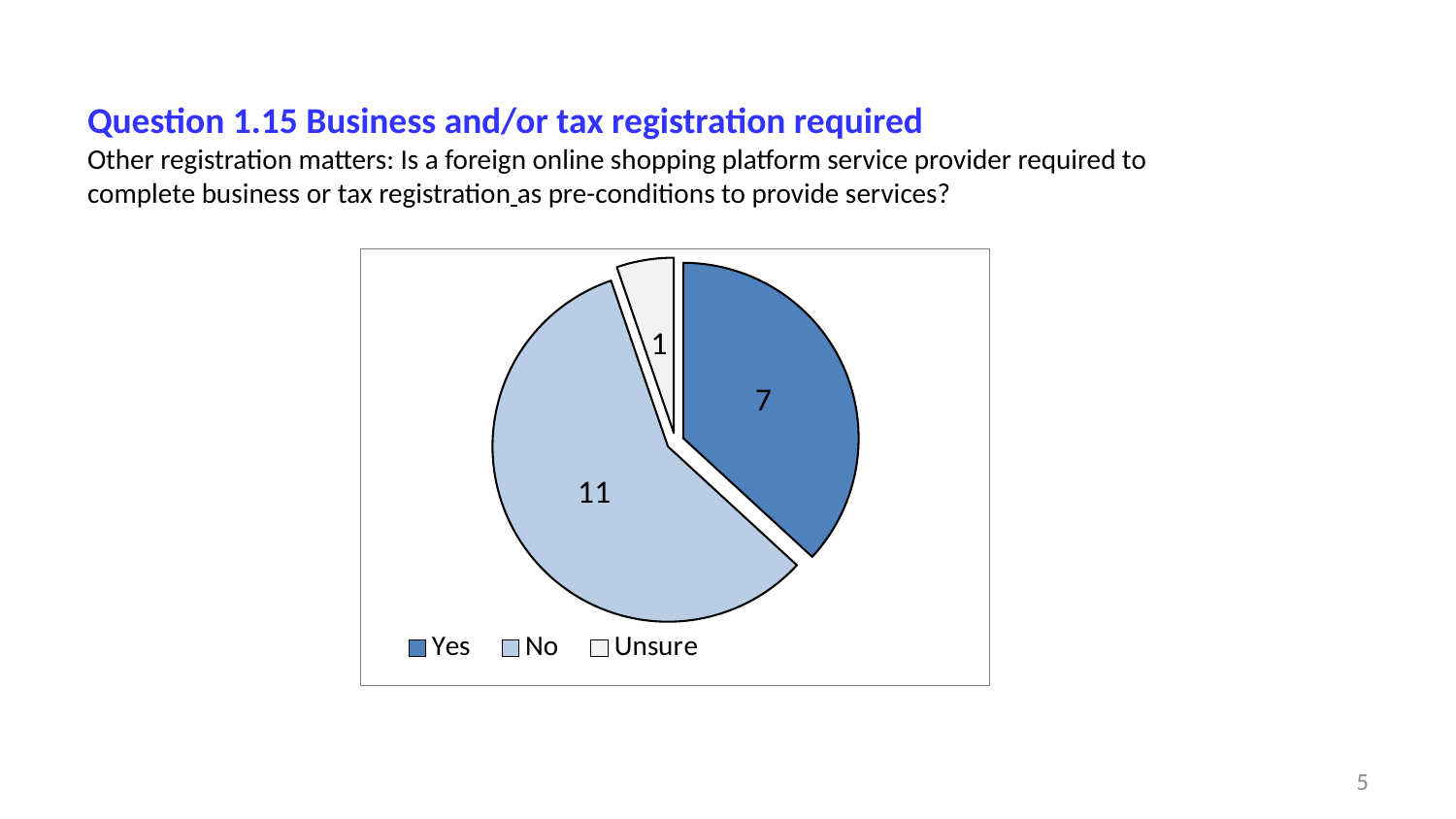
How many entries does the legend list? 3 Which category has the smallest slice? Unsure What is the difference between the values for No and Yes? 4 What is the value for Yes? 7 What is the value for No? 11 What is the total of all slices in the pie chart? 19 Which category has the largest slice? No How many categories does the pie chart have? 3 What is the value for Unsure? 1 What kind of chart is shown on the slide? pie chart Which legend entry is shown in the darkest blue? Yes Which is larger, the value for Yes or the value for Unsure? Yes